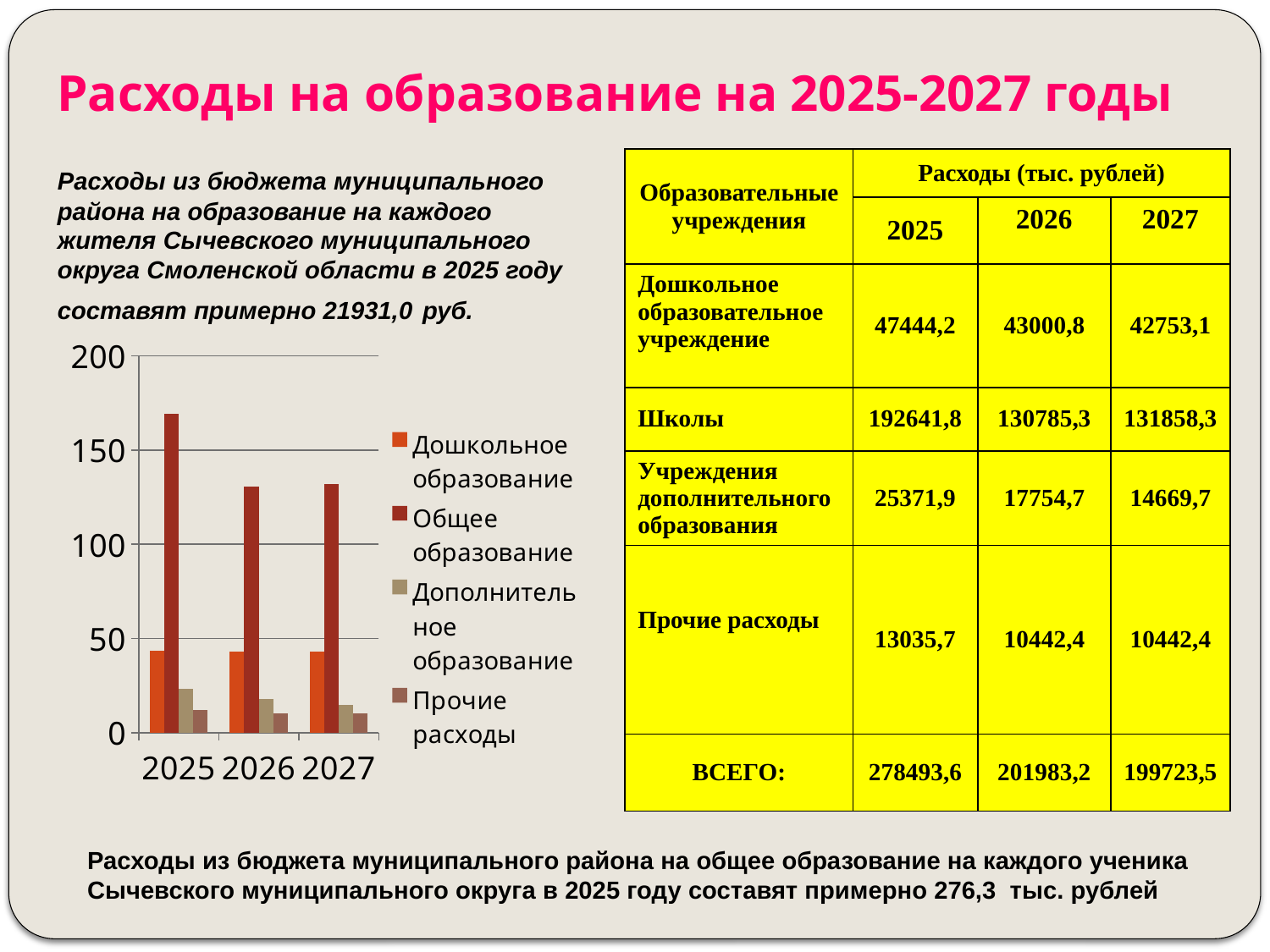
How many series does the chart legend list? 4 How many years are shown on the x axis of the chart? 3 Is the value for Общее образование in 2025 greater or less than 150? greater Which is larger on the chart: Общее образование in 2025 or Общее образование in 2026? Общее образование in 2025 In which year is the bar for Общее образование the highest? 2025 What kind of chart is shown on the slide? bar chart Is the value for Общее образование in 2026 greater or less than 150? less Which series has the tallest bar in 2025 on the chart? Общее образование Is the value for Дошкольное образование in 2025 greater or less than 50? less Do the bars for Дополнительное образование rise or fall from 2025 to 2027? fall Which series has the shortest bar in 2025 on the chart? Прочие расходы Which series is listed first in the chart legend? Дошкольное образование